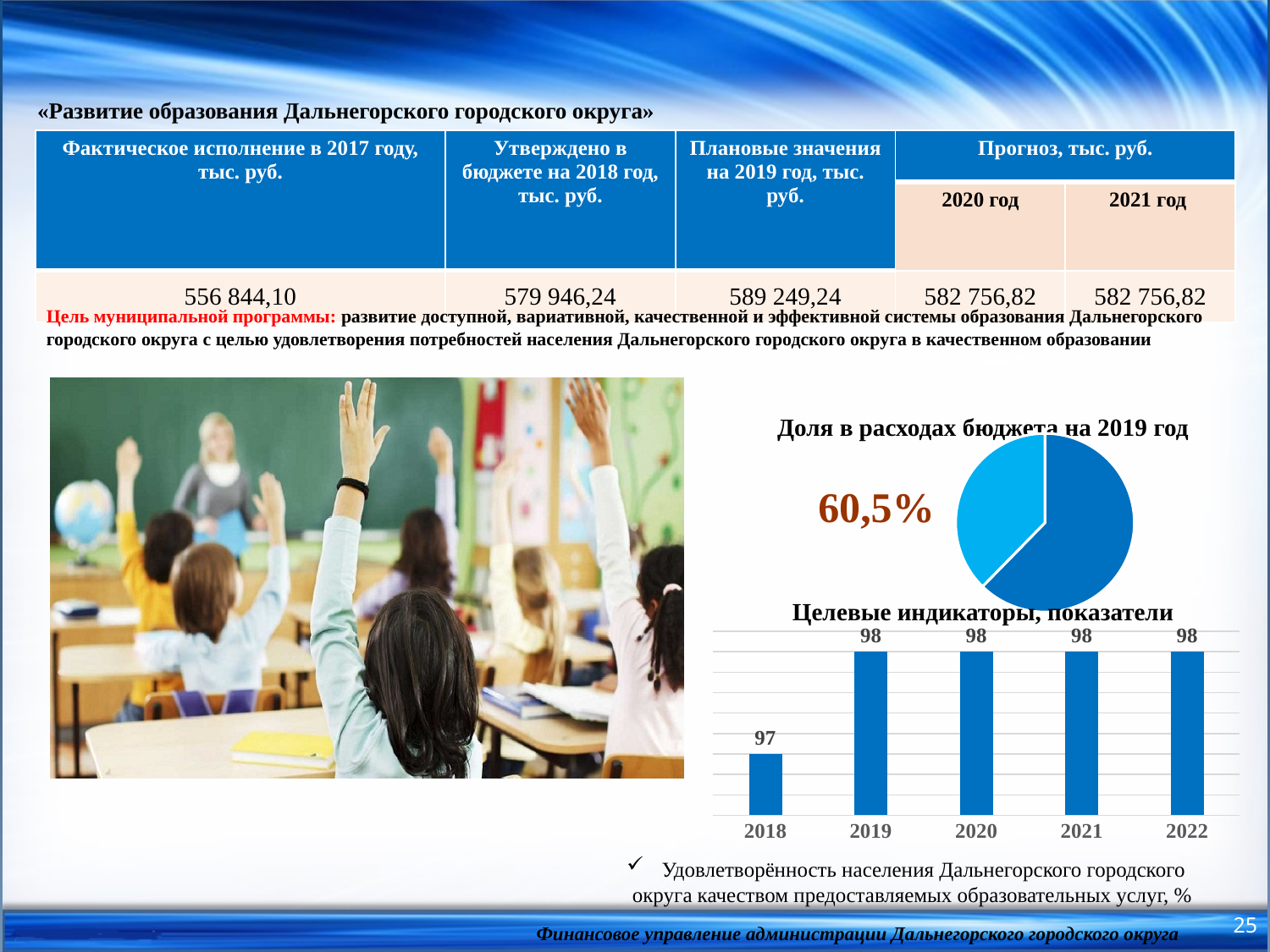
How many years are shown on the x axis of the bar chart 'Целевые индикаторы, показатели'? 5 In the pie chart 'Доля в расходах бюджета на 2019 год', what share is printed next to the chart? 60,5% In the bar chart 'Целевые индикаторы, показатели', what is the value for 2018? 97 In the bar chart 'Целевые индикаторы, показатели', which year has the lowest value? 2018 In the bar chart 'Целевые индикаторы, показатели', what is the difference between the values for 2019 and 2018? 1 In the bar chart 'Целевые индикаторы, показатели', what is the value for 2022? 98 In the bar chart 'Целевые индикаторы, показатели', what is the value for 2020? 98 What is the title of the bar chart on the slide? Целевые индикаторы, показатели What kind of chart is 'Целевые индикаторы, показатели'? bar chart In the bar chart 'Целевые индикаторы, показатели', do the values rise or fall from 2018 to 2019? rise What kind of chart is 'Доля в расходах бюджета на 2019 год'? pie chart In the bar chart 'Целевые индикаторы, показатели', which is larger, the value for 2018 or the value for 2021? 2021